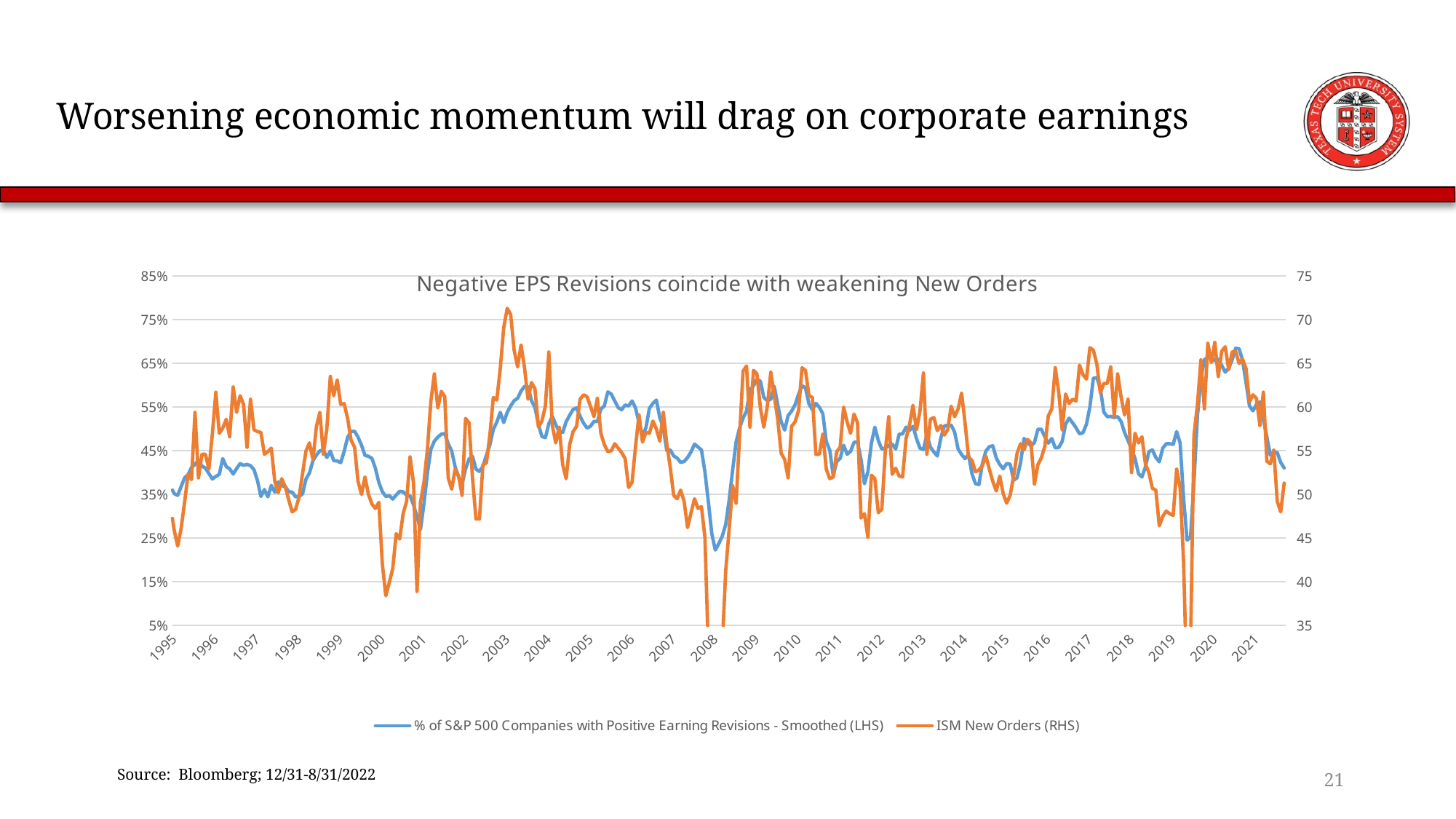
What is the title of the chart? Negative EPS Revisions coincide with weakening New Orders What kind of chart is shown on the slide? Line chart Is the lowest value of the ISM New Orders line around 2008 greater or less than 40? less What is the lowest value shown on the right-hand vertical axis? 35 What is the highest value shown on the left-hand vertical axis? 85% Which series is plotted in orange? ISM New Orders (RHS) Is the peak of the % of S&P 500 Companies with Positive Earning Revisions line around 2020-2021 greater or less than 65%? greater What is the last year labelled on the x axis? 2021 Does the % of S&P 500 Companies with Positive Earning Revisions line rise or fall from its 2020-2021 peak to the end of the chart? Fall What is the first year labelled on the x axis? 1995 How many series does the legend list? 2 Is the peak of the ISM New Orders line around 2003 greater or less than 65? greater